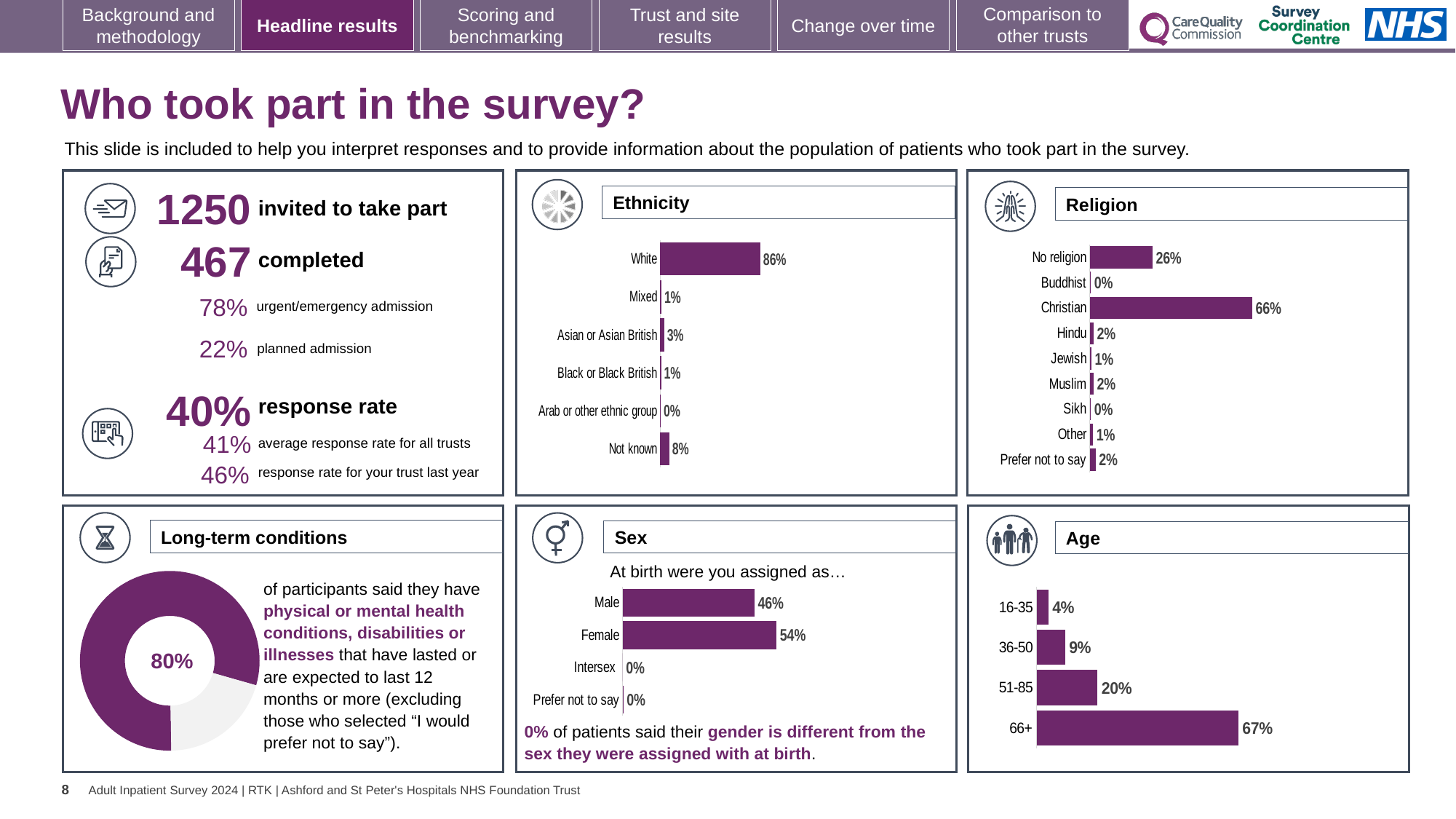
In the Age chart, do the values rise or fall from the 16-35 group to the 66+ group? rise In the Ethnicity chart, what percentage of participants were White? 86% In the Ethnicity chart, which category has the highest value? White In the Religion chart, which is larger, No religion or Christian? Christian In the Ethnicity chart, what is the difference between the White and Not known values? 78% In the Religion chart, what percentage of participants were Christian? 66% How many categories does the Religion chart show? 9 In the Sex chart, what percentage of participants were assigned Female at birth? 54% In the Age chart, which age group has the highest value? 66+ In the Sex chart, what is the difference between the Female and Male values? 8% How many categories does the Ethnicity chart show? 6 What kind of chart is the Long-term conditions chart? doughnut chart